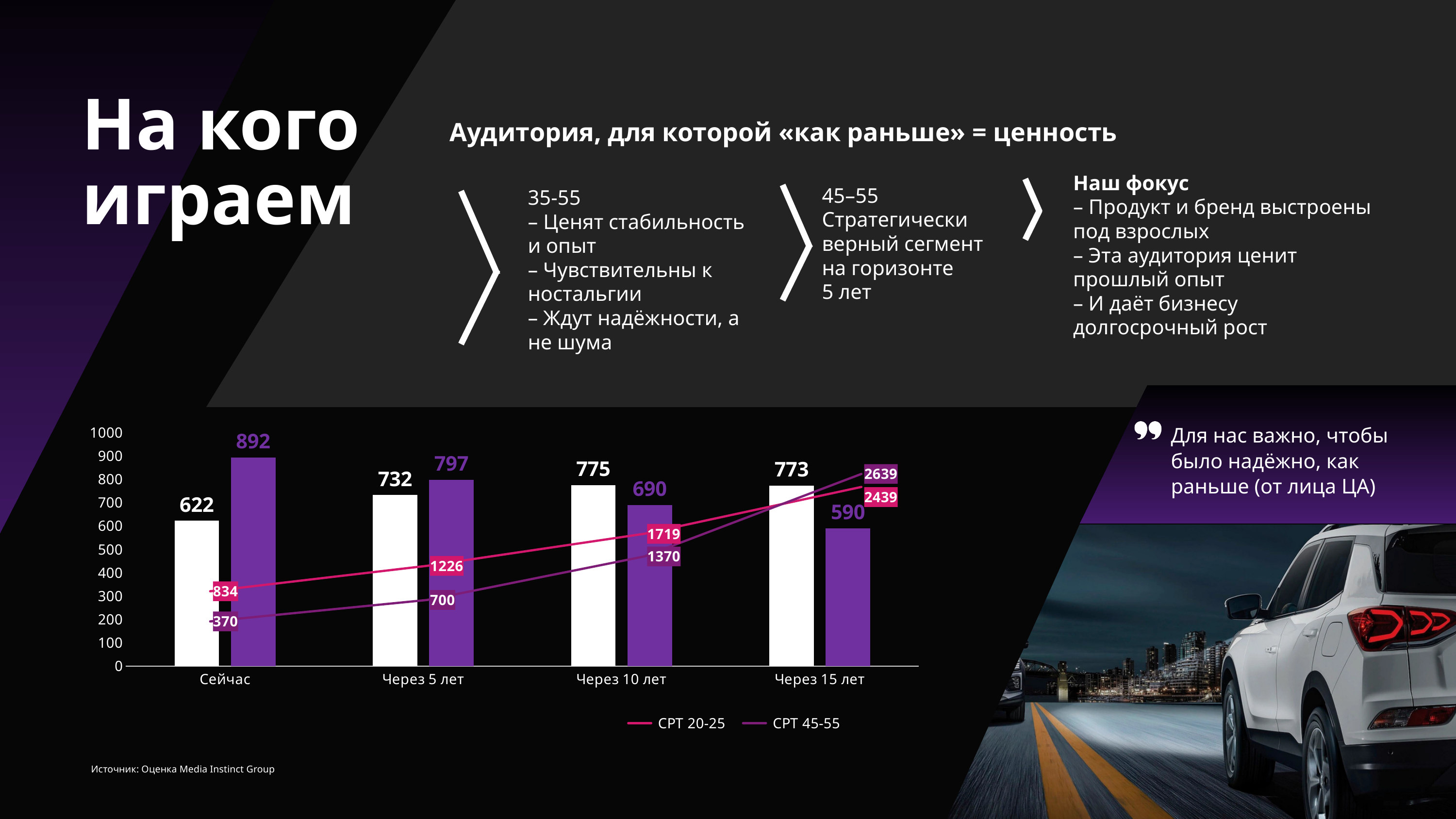
Does the CPT 45-55 line rise or fall from «Сейчас» to «Через 15 лет»? rises In which category is the white bar lowest? Сейчас What kind of chart is shown on the slide? a combined bar and line chart How many categories are shown on the x axis? 4 What is the CPT 45-55 value for «Сейчас»? 370 Which is larger for «Через 5 лет»: the white bar or the purple bar? the purple bar (797) What is the CPT 20-25 value for «Через 10 лет»? 1719 What is the difference between the CPT 45-55 and CPT 20-25 values for «Через 15 лет»? 200 In which category is the purple bar highest? Сейчас What is the value of the purple bar for «Через 15 лет»? 590 How many series does the legend list? 2 What is the value of the white bar for «Сейчас»? 622